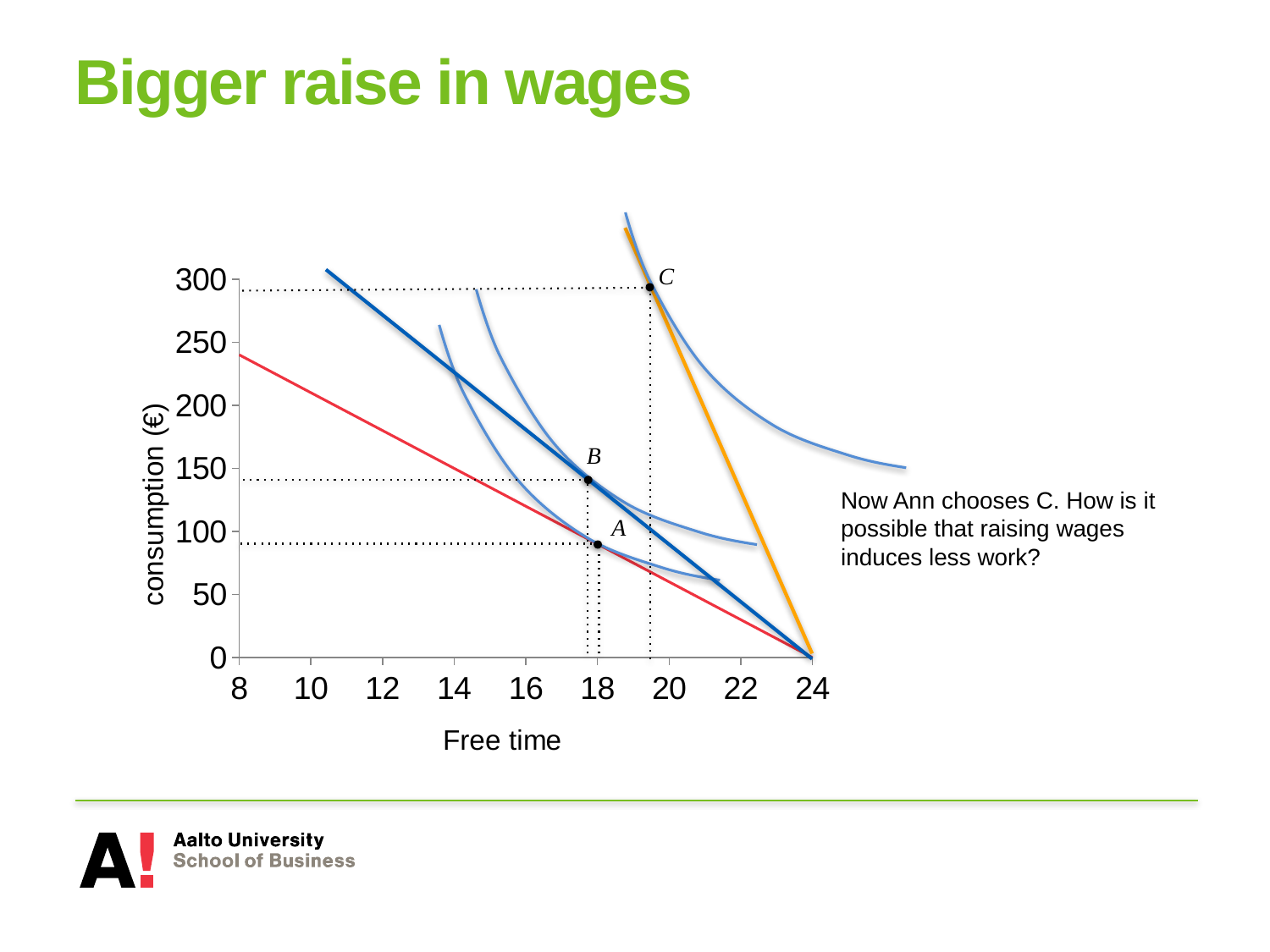
Which labelled point has the highest consumption? C What kind of chart is shown on the slide? line chart What is the label of the y axis? consumption (€) What is the label of the x axis? Free time Which point has higher consumption, B or C? C How many labelled points (A, B, C) are marked on the chart? 3 Is the consumption at point B greater or less than 100? greater Which labelled point has the lowest consumption? A Is the consumption at point C greater or less than 250? greater Is the consumption at point A greater or less than 100? less Which labelled point has the most free time? C At what value of free time do the budget lines meet the x axis? 24